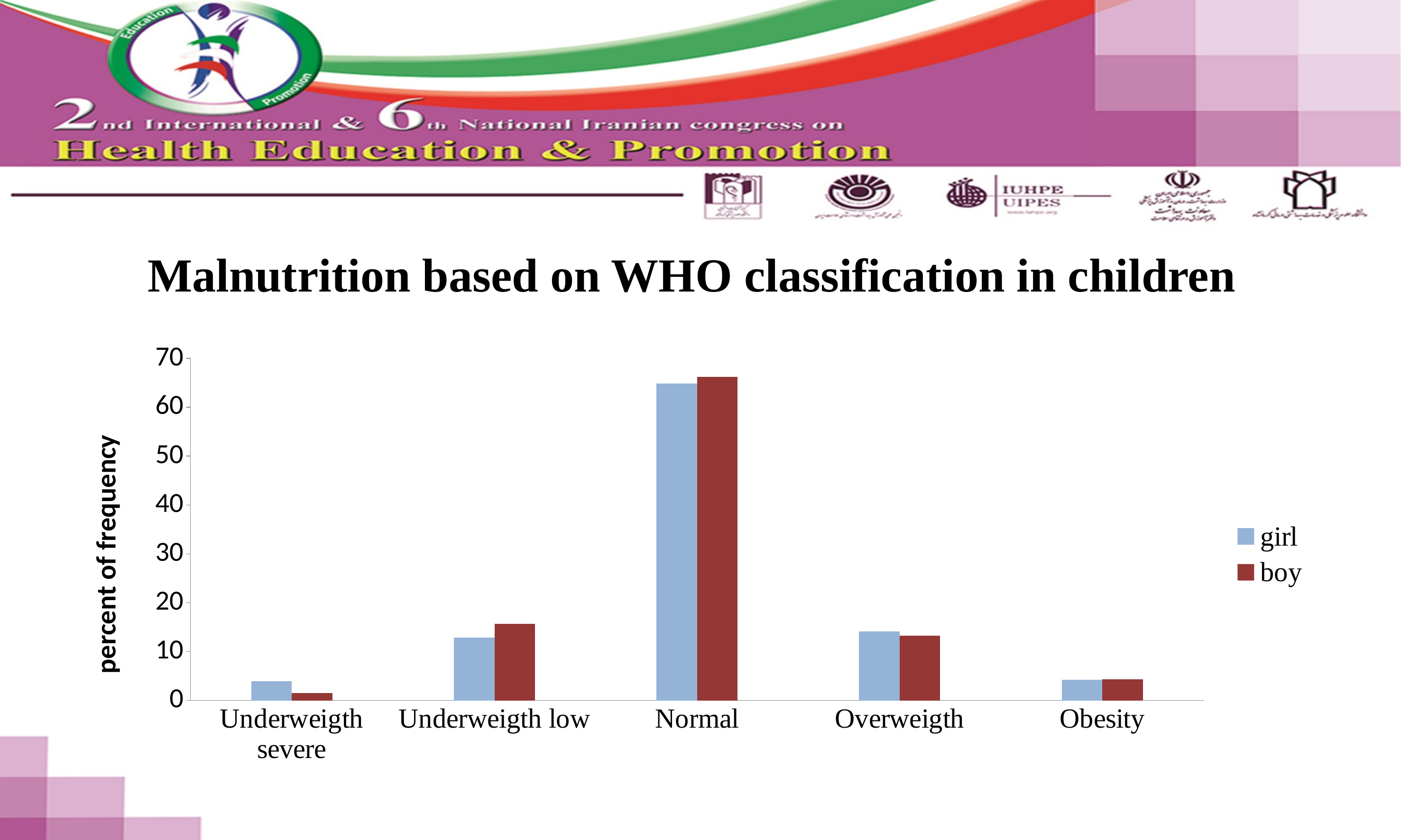
Which category has the lowest value for the boy series? Underweigth severe What kind of chart is shown on the slide? bar chart Is the value for girl in the Normal category greater or less than 60? greater For the Underweigth severe category, which series has the larger value, girl or boy? girl For the Underweigth low category, which series has the larger value, girl or boy? boy What is the label on the vertical axis of the chart? percent of frequency Which category has the highest value for the boy series? Normal Is the value for girl in the Overweigth category greater or less than 10? greater Is the value for boy in the Obesity category greater or less than 10? less Which category has the highest value for the girl series? Normal How many categories are shown on the x axis of the chart? 5 How many series does the chart's legend list? 2